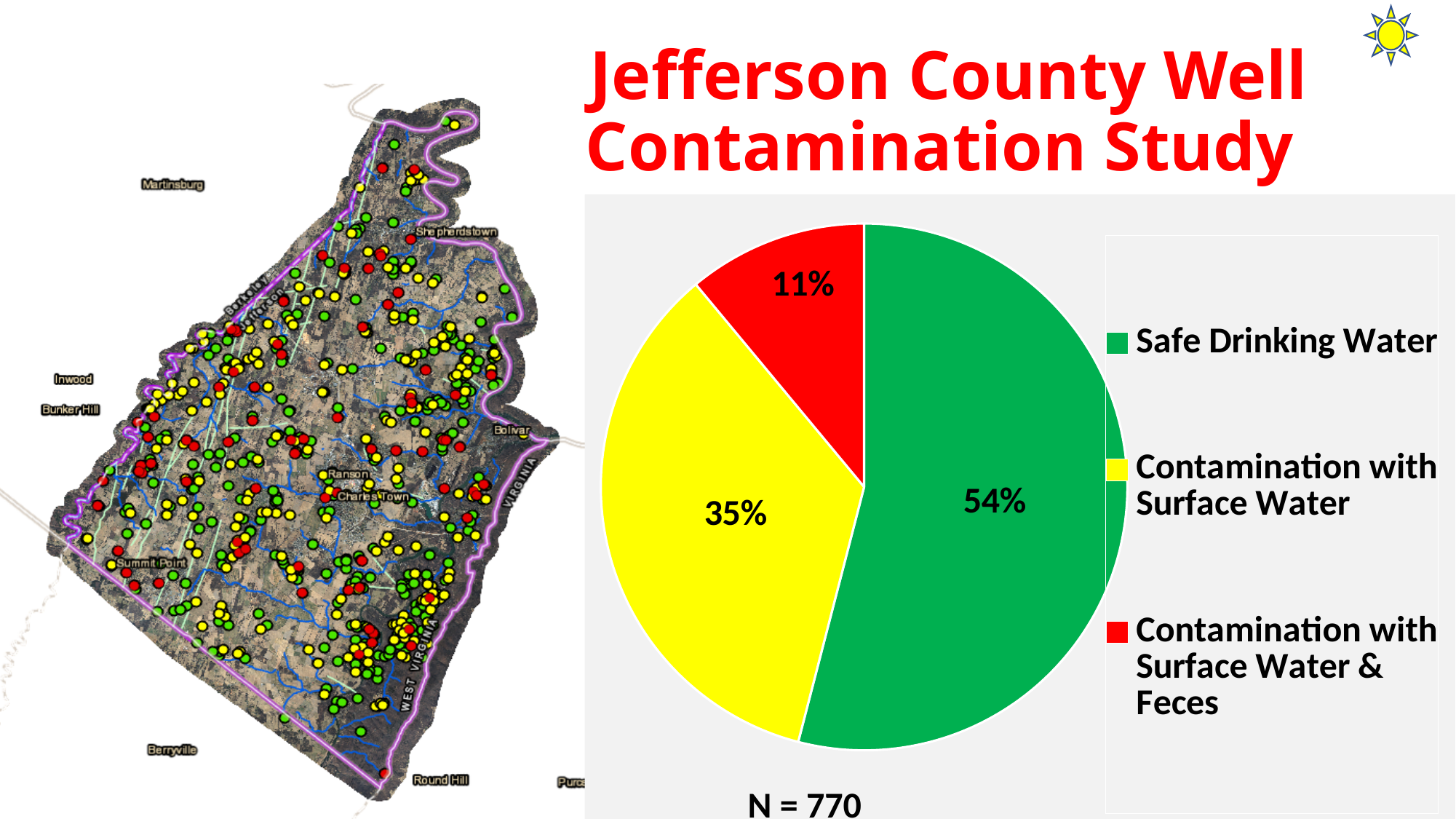
What share of the pie chart is Contamination with Surface Water & Feces? 11% Which category has the smallest slice of the pie chart? Contamination with Surface Water & Feces How many categories does the pie chart show? 3 What colour represents Contamination with Surface Water in the pie chart? Yellow What kind of chart is shown on the slide? Pie chart What is the difference in percentage points between Contamination with Surface Water and Contamination with Surface Water & Feces? 24 What share of the pie chart is Contamination with Surface Water? 35% What is the difference in percentage points between Safe Drinking Water and Contamination with Surface Water? 19 What is the sample size (N) stated below the pie chart? N = 770 Which category has the largest slice of the pie chart? Safe Drinking Water Which is larger: Contamination with Surface Water or Contamination with Surface Water & Feces? Contamination with Surface Water What share of the pie chart is Safe Drinking Water? 54%